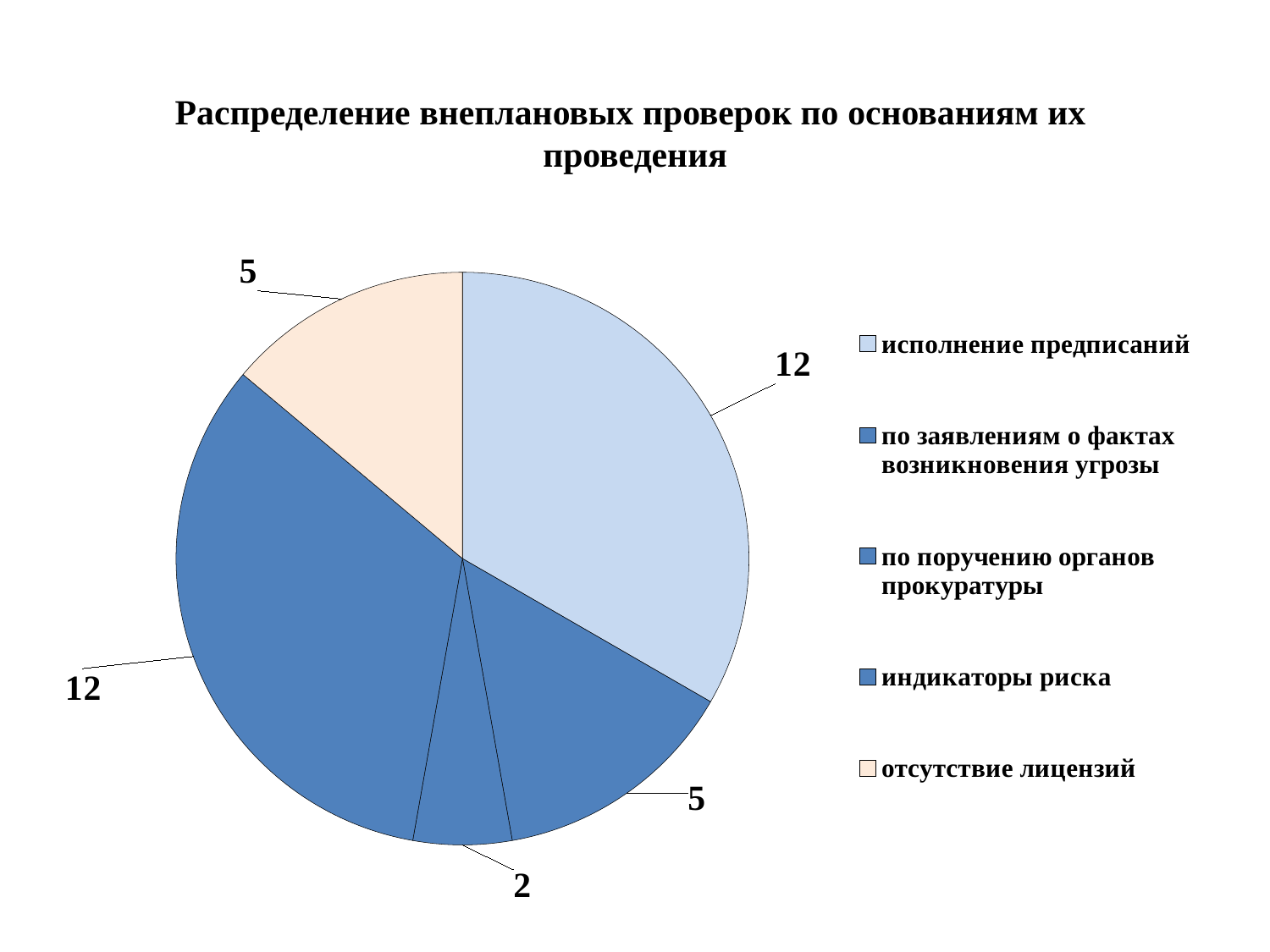
What is the total of all slice values in the pie chart? 36 What is the value for «исполнение предписаний»? 12 Which categories are tied for the largest slice? исполнение предписаний and индикаторы риска What is the value for «индикаторы риска»? 12 What is the value for «отсутствие лицензий»? 5 How many slices does the pie chart have? 5 What is the title of the chart? Распределение внеплановых проверок по основаниям их проведения What is the difference between the values for «исполнение предписаний» and «отсутствие лицензий»? 7 Which category has the smallest slice? по поручению органов прокуратуры Which is larger: «индикаторы риска» or «по заявлениям о фактах возникновения угрозы»? индикаторы риска What is the value for «по поручению органов прокуратуры»? 2 What kind of chart is shown on the slide? Pie chart